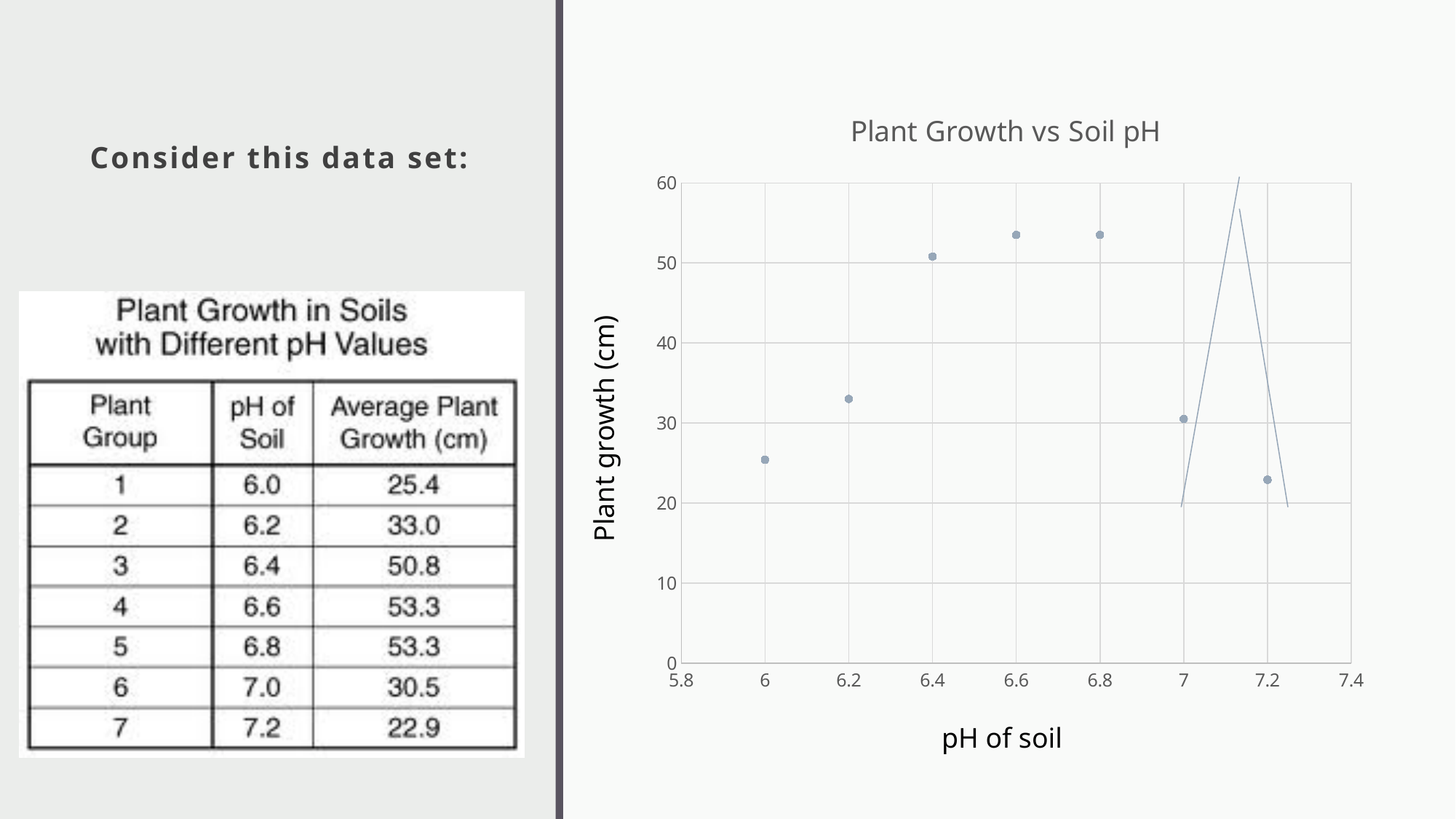
Is the plant growth at pH 6.4 greater or less than 50? greater According to the slide, what is the plant growth at a soil pH of 6.4? 50.8 At which soil pH is plant growth lowest? 7.2 What kind of chart is shown on the slide? Scatter chart How many data points are plotted on the chart? 7 Which has higher plant growth, pH 6.6 or pH 7.0? pH 6.6 According to the slide, what is the plant growth at a soil pH of 7.0? 30.5 Is the plant growth at pH 7.2 greater or less than 20? greater What is the title of the chart? Plant Growth vs Soil pH What is the label of the y axis of the chart? Plant growth (cm) Is the plant growth at pH 6.0 greater or less than 30? less What is the difference in plant growth between pH 6.6 and pH 6.0? 27.9